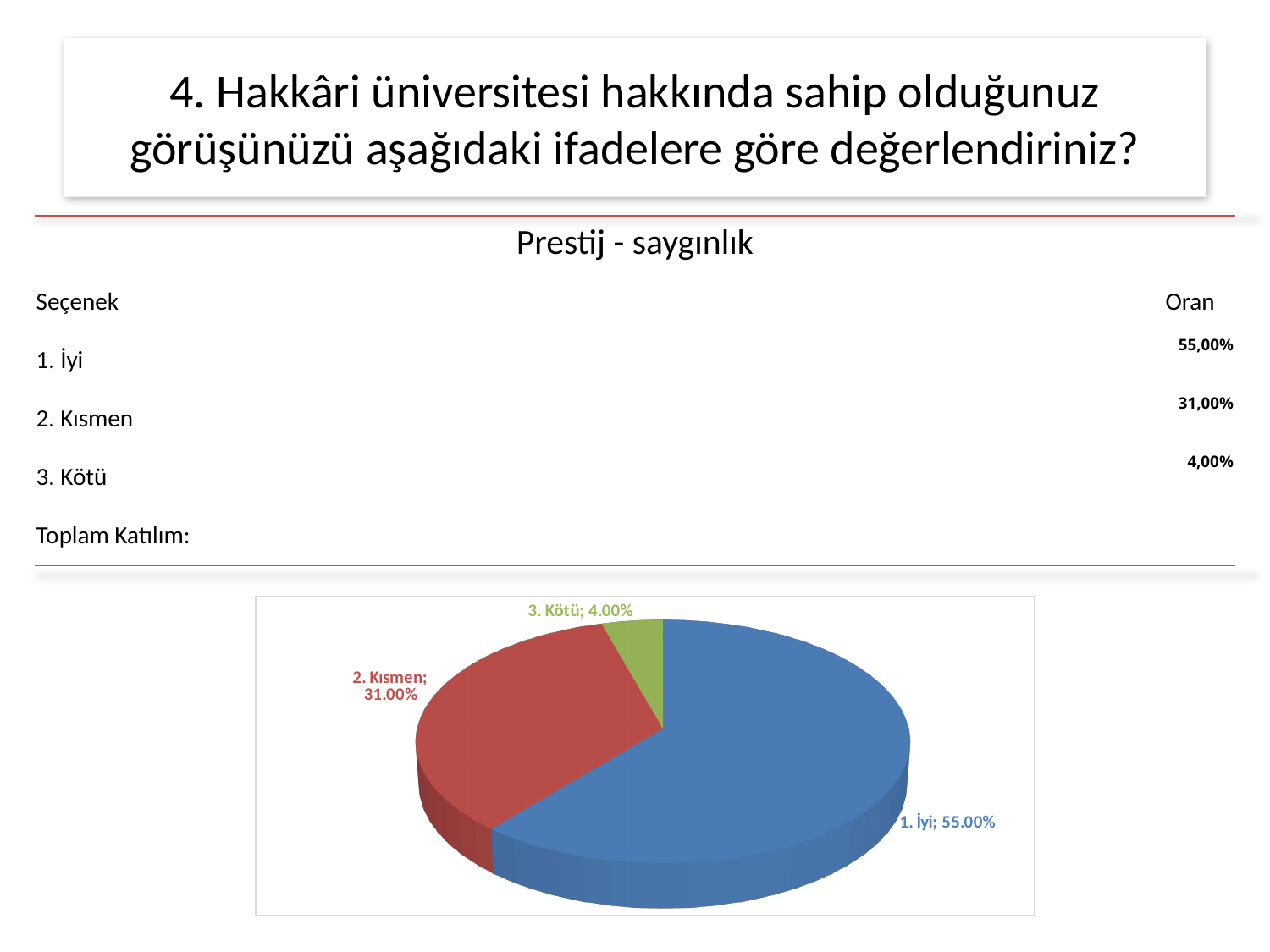
What is the value shown for the "1. İyi" slice in the pie chart? 55.00% Which category has the smallest slice in the pie chart? 3. Kötü What is the difference in percentage points between the "1. İyi" slice and the "2. Kısmen" slice in the pie chart? 24.00% Which is larger in the pie chart, the slice for "2. Kısmen" or the slice for "3. Kötü"? 2. Kısmen What kind of chart is shown on the slide? pie chart What colour is the "3. Kötü" slice in the pie chart? green What is the difference in percentage points between the "2. Kısmen" slice and the "3. Kötü" slice in the pie chart? 27.00% What is the value shown for the "2. Kısmen" slice in the pie chart? 31.00% What colour is the "1. İyi" slice in the pie chart? blue Which category has the largest slice in the pie chart? 1. İyi What is the value shown for the "3. Kötü" slice in the pie chart? 4.00% How many slices does the pie chart have? 3